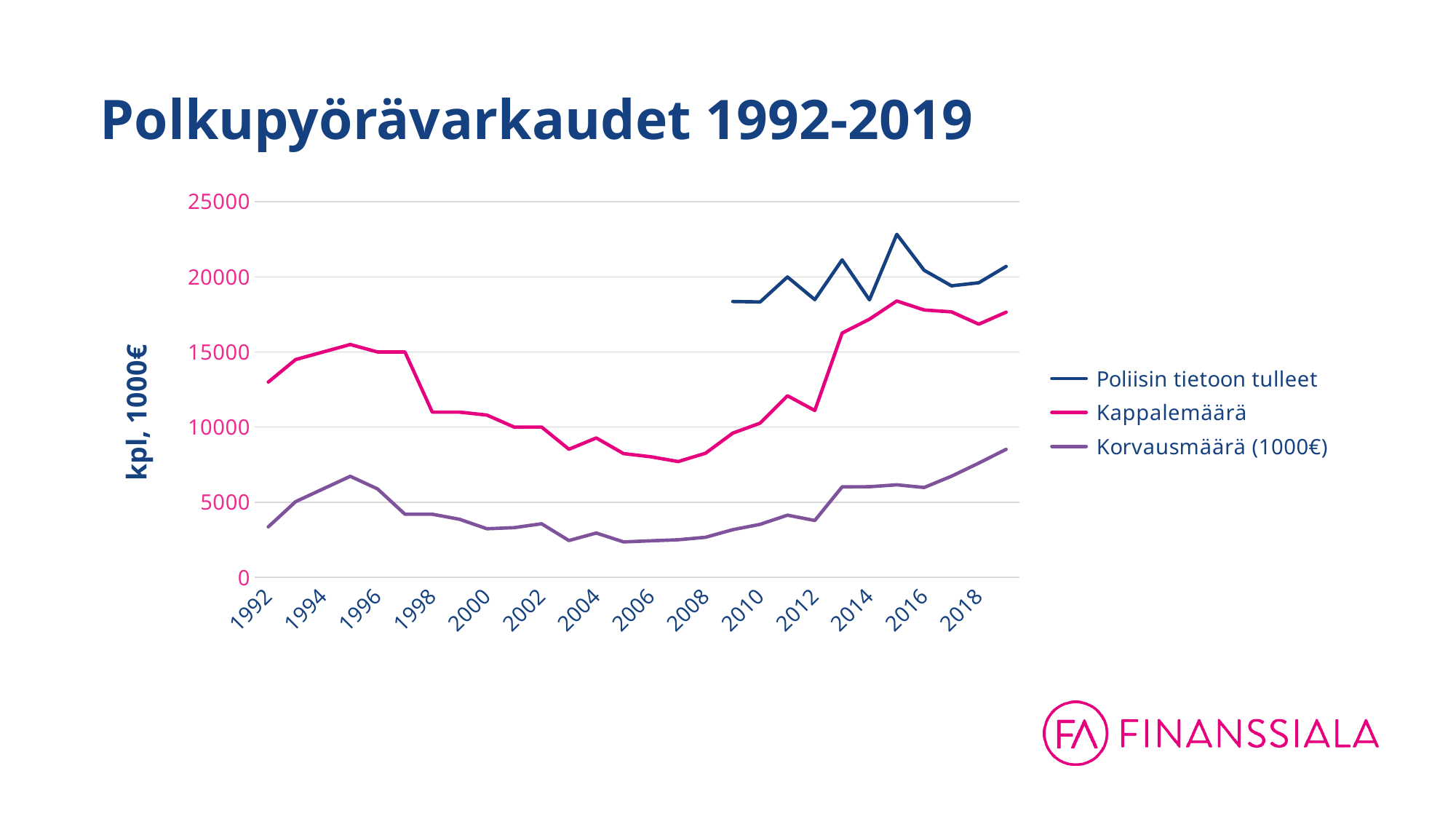
What kind of chart is shown on the slide? line chart In 2019, which is higher, Kappalemäärä or Korvausmäärä (1000€)? Kappalemäärä Is the value for Korvausmäärä (1000€) in 2019 greater or less than 5000? greater Does Korvausmäärä (1000€) rise or fall from 2013 to 2019? rise Is the value for Kappalemäärä in 1992 greater or less than 10000? greater In which year is Korvausmäärä (1000€) at its highest? 2019 Is the value for Kappalemäärä in 2007 greater or less than 10000? less What is the title of the chart? Polkupyörävarkaudet 1992-2019 How many series does the legend list? 3 In which year is Poliisin tietoon tulleet at its highest? 2015 Which series only has data starting from 2009? Poliisin tietoon tulleet